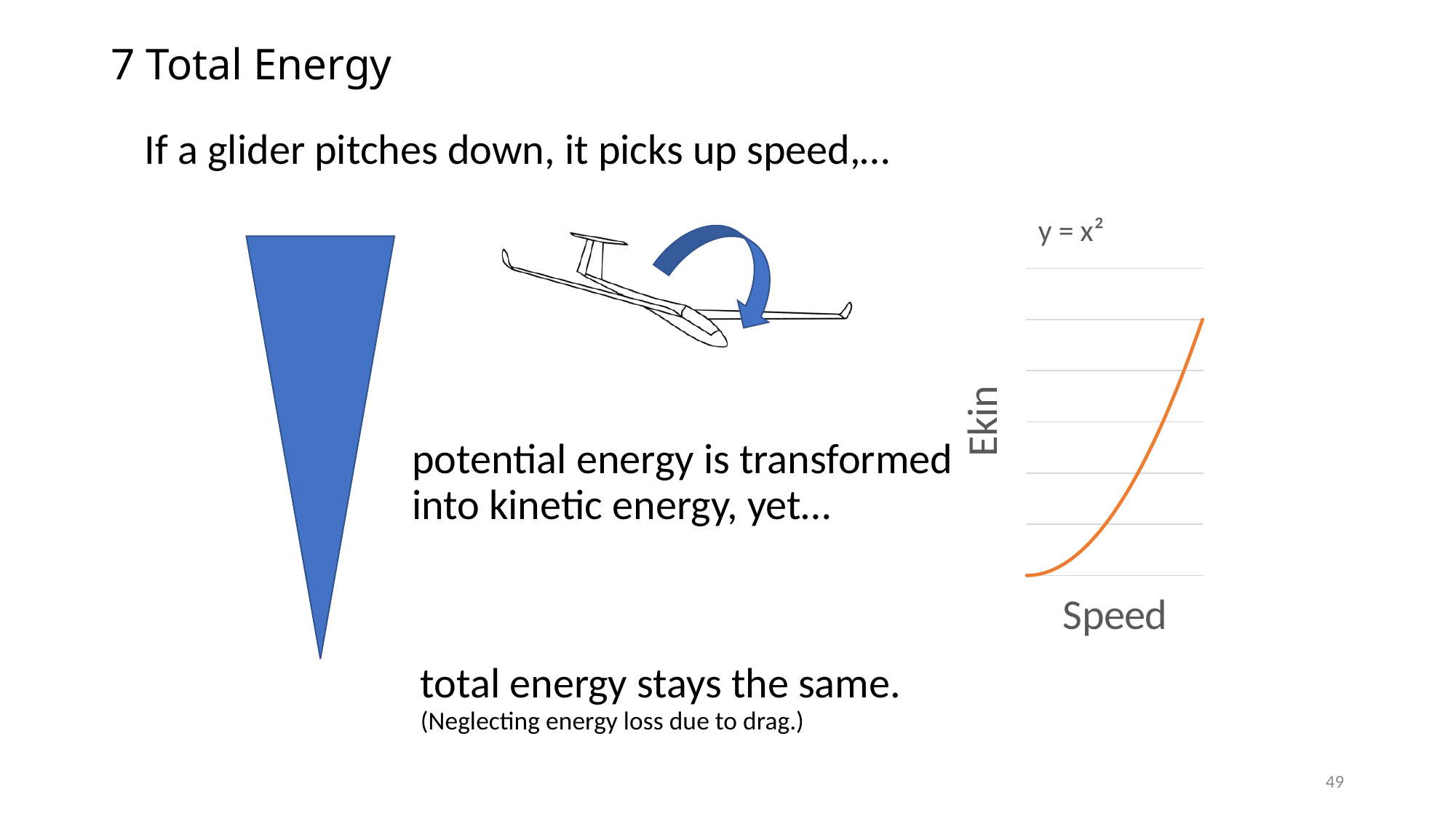
What is the label of the vertical axis of the chart? Ekin What is the label of the horizontal axis of the chart? Speed How many lines are plotted on the chart? 1 What kind of chart is shown on the right of the slide? line chart Does the plotted line rise or fall as Speed increases? rises